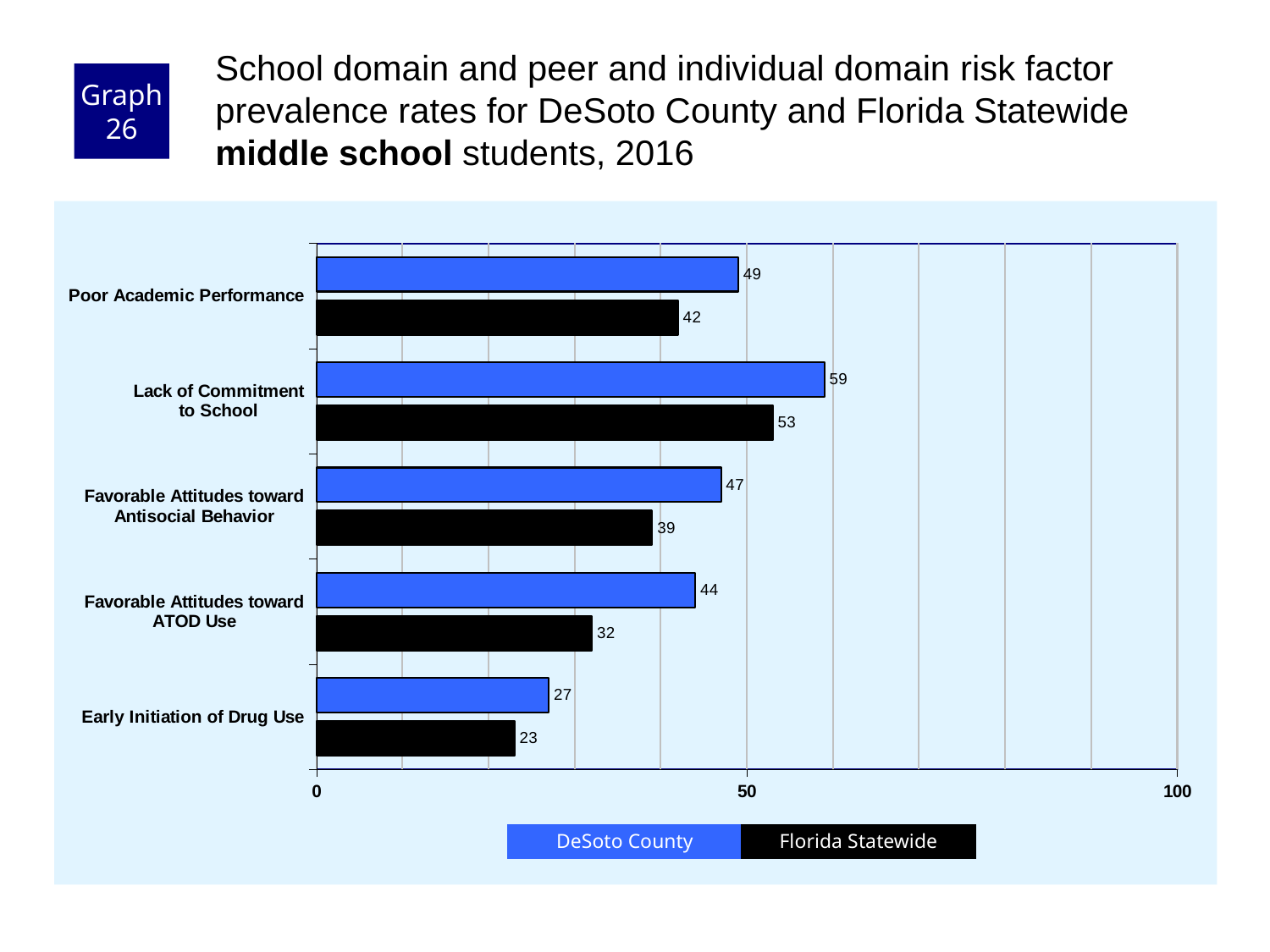
What is the DeSoto County value for Lack of Commitment to School? 59 How many risk factor categories are shown on the chart? 5 What kind of chart is shown on the slide? bar chart Which risk factor has the highest DeSoto County value? Lack of Commitment to School Which risk factor has the lowest Florida Statewide value? Early Initiation of Drug Use Is the DeSoto County value for Lack of Commitment to School greater or less than 50? greater What is the difference between the DeSoto County and Florida Statewide values for Poor Academic Performance? 7 What is the difference between the DeSoto County and Florida Statewide values for Favorable Attitudes toward ATOD Use? 12 What is the Florida Statewide value for Favorable Attitudes toward ATOD Use? 32 Which is larger for Favorable Attitudes toward Antisocial Behavior: the DeSoto County value or the Florida Statewide value? DeSoto County How many series does the legend list? 2 What is the Florida Statewide value for Early Initiation of Drug Use? 23